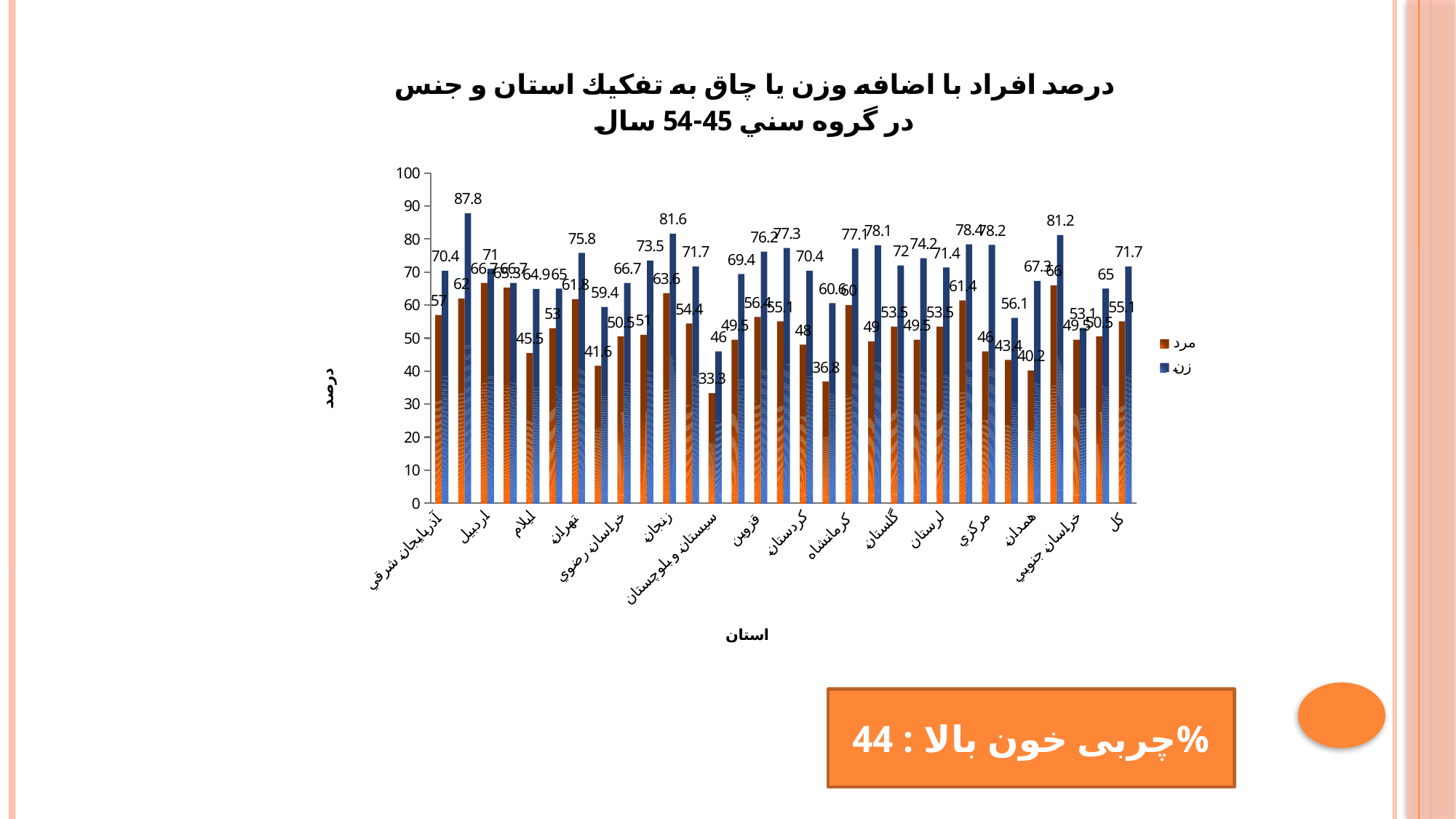
Is the زن (women) value for ایلام greater or less than 60? greater Which has the larger زن (women) value: مرکزی or همدان? مرکزی Which labeled province has the lowest value for زن (women)? سیستان و بلوچستان What is the value for مرد (men) in سیستان و بلوچستان? 33.3 What is the value for مرد (men) in تهران? 61.8 What kind of chart is shown on the slide? bar chart What is the value for زن (women) in the کل (total) category? 71.7 What is the value for مرد (men) in the کل (total) category? 55.1 In the کل (total) category, what is the difference between the زن (women) value and the مرد (men) value? 16.6 In تهران, how much higher is the زن (women) value than the مرد (men) value? 14 How many series does the legend list? 2 What is the value for زن (women) in زنجان? 81.6